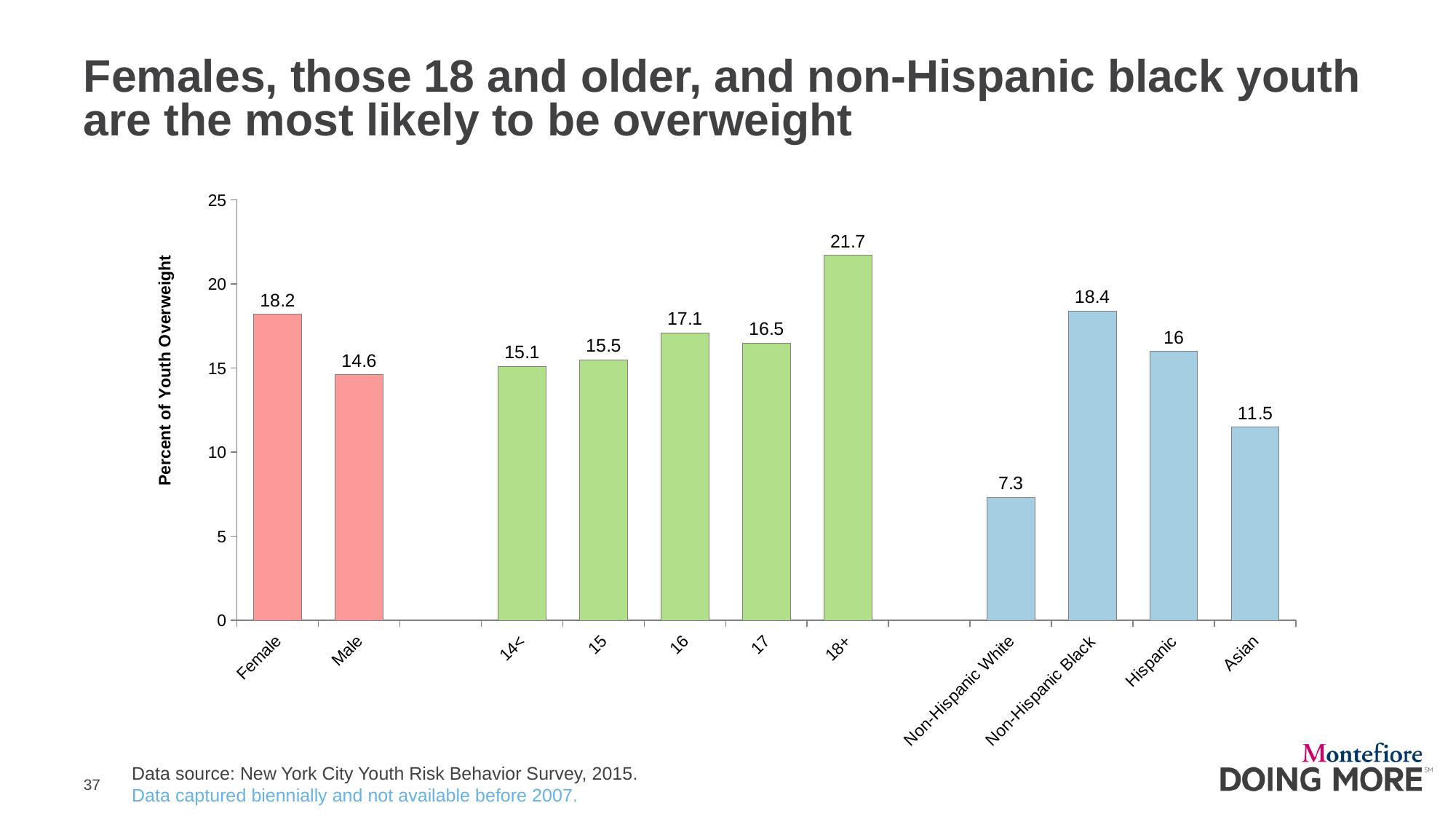
What is the difference between the Female and Male values? 3.6 What kind of chart is shown on the slide? Bar chart How many categories are shown on the x axis? 11 What is the percent of youth overweight for Female? 18.2 Which is larger, the value for Non-Hispanic Black or the value for Hispanic? Non-Hispanic Black Which category has the highest percent of youth overweight? 18+ What is the percent of youth overweight for Non-Hispanic White? 7.3 What is the label of the y axis? Percent of Youth Overweight What is the percent of youth overweight for the 18+ age group? 21.7 Do the values rise or fall across the age groups from 14< to 18+? Rise overall (from 15.1 to 21.7), though 17 dips slightly below 16 Which category has the lowest percent of youth overweight? Non-Hispanic White Is the value for Asian greater or less than 10? greater